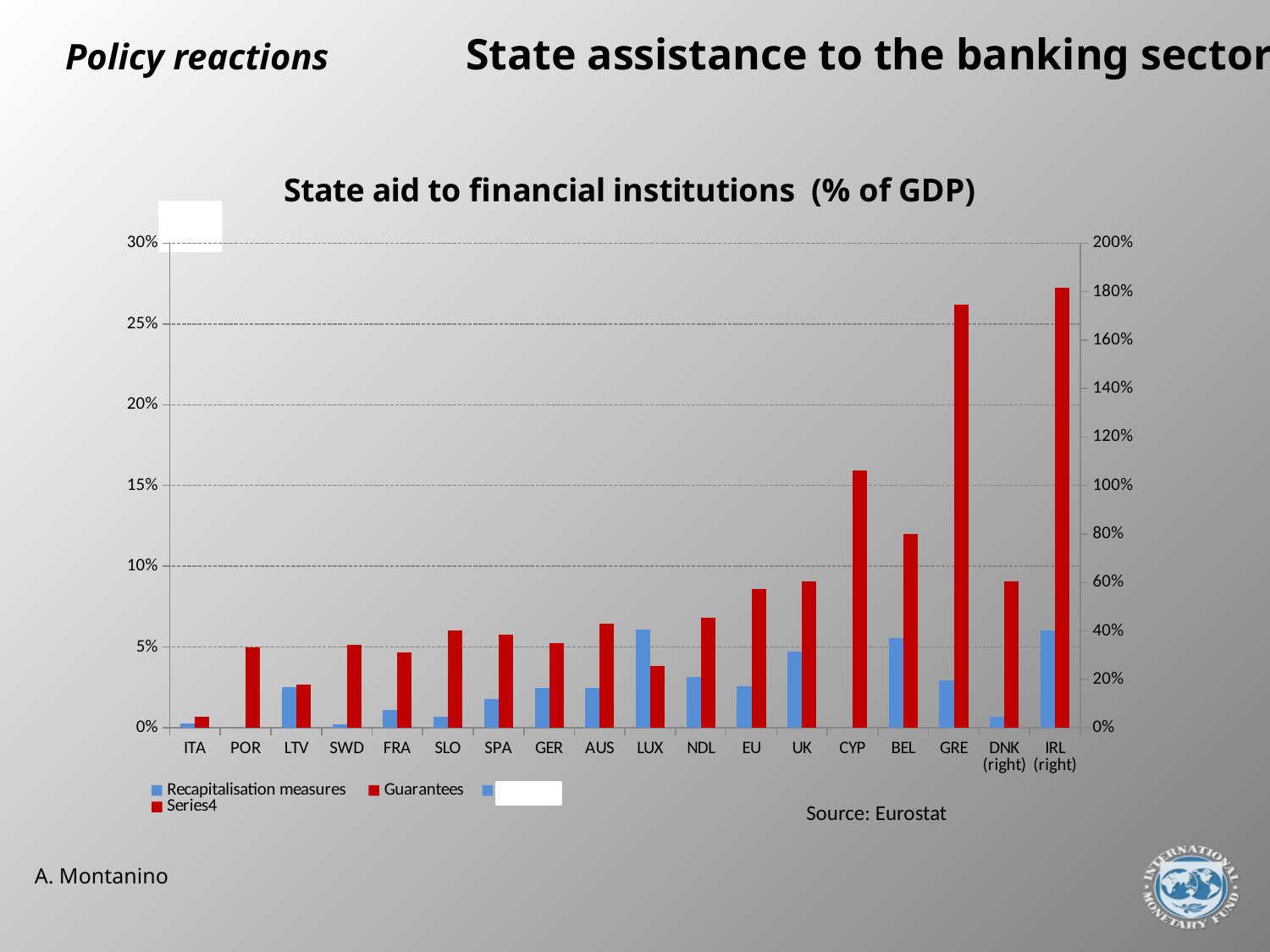
What is the title of the chart? State aid to financial institutions (% of GDP) Is the Guarantees value for CYP greater or less than 15%? greater How many categories are shown along the x axis of the chart? 18 Is the Guarantees value for DNK (right), read on the right axis, greater or less than 80%? less What source is cited for the chart? Eurostat What kind of chart is shown on the slide? bar chart Is the Recapitalisation measures value for LUX greater or less than 5%? greater Which has the larger Guarantees value, CYP or BEL? CYP For LUX, which is larger: Recapitalisation measures or Guarantees? Recapitalisation measures Which category has the tallest Guarantees bar? IRL (right)